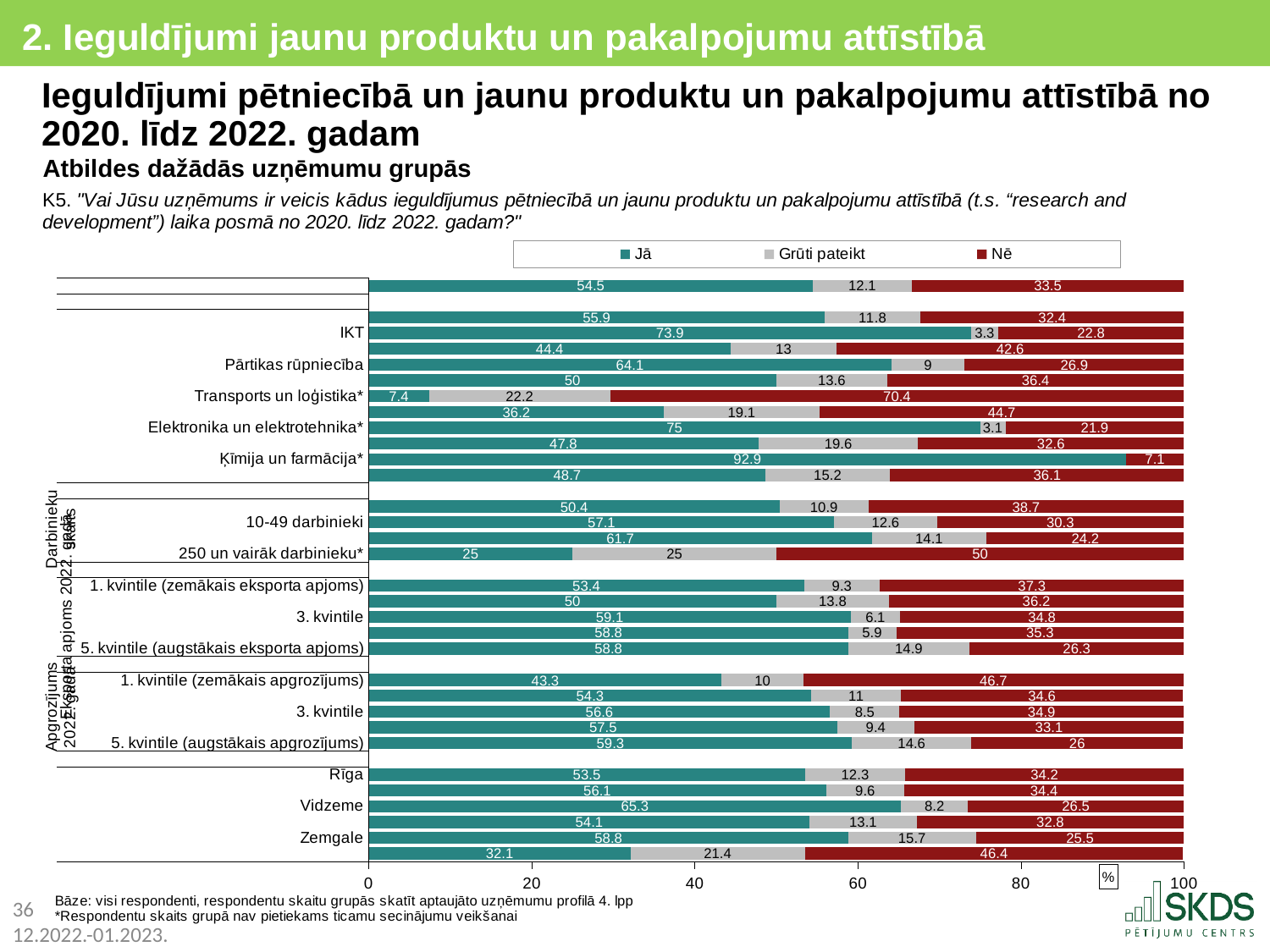
How much larger is the Jā value for Vidzeme than for Rīga? 11.8 What is the value of the Jā series for IKT? 73.9 Which has the larger Nē value, Rīga or Zemgale? Rīga What kind of chart is shown on the slide? Stacked bar chart What is the value of the Grūti pateikt series for Vidzeme? 8.2 What is the total of the three segments in the bar for 250 un vairāk darbinieku*? 100 Among the labelled categories, which has the lowest Jā value? Transports un loģistika* Is the Nē value for 1. kvintile (zemākais apgrozījums) greater or less than 40? greater What is the value of the Nē series for Transports un loģistika*? 70.4 Among the labelled categories, which has the highest Jā value? Ķīmija un farmācija* How many series does the legend list? 3 What is the value of the Jā series for 250 un vairāk darbinieku*? 25